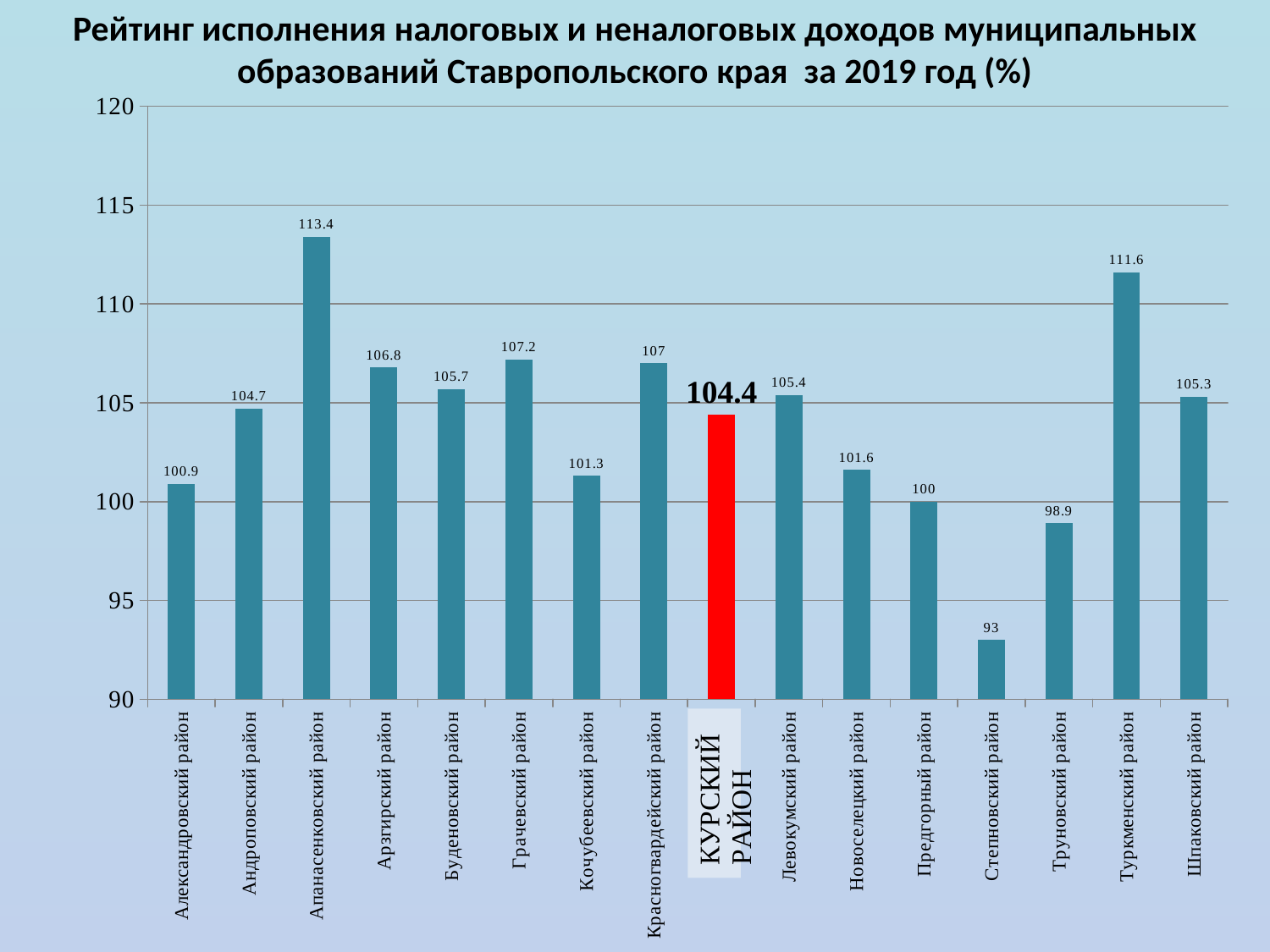
Is the value for Труновский район greater or less than 100? less What is the value for Курский район? 104.4 What is the value for Апанасенковский район? 113.4 Which is larger, the value for Грачевский район or the value for Красногвардейский район? Грачевский район Which district has the lowest value? Степновский район How many districts are shown on the chart? 16 What is the value for Степновский район? 93 What is the value for Предгорный район? 100 Which district has the highest value? Апанасенковский район What is the difference between the values for Туркменский район and Курский район? 7.2 What kind of chart is shown on the slide? bar chart Which bar is highlighted in red? Курский район